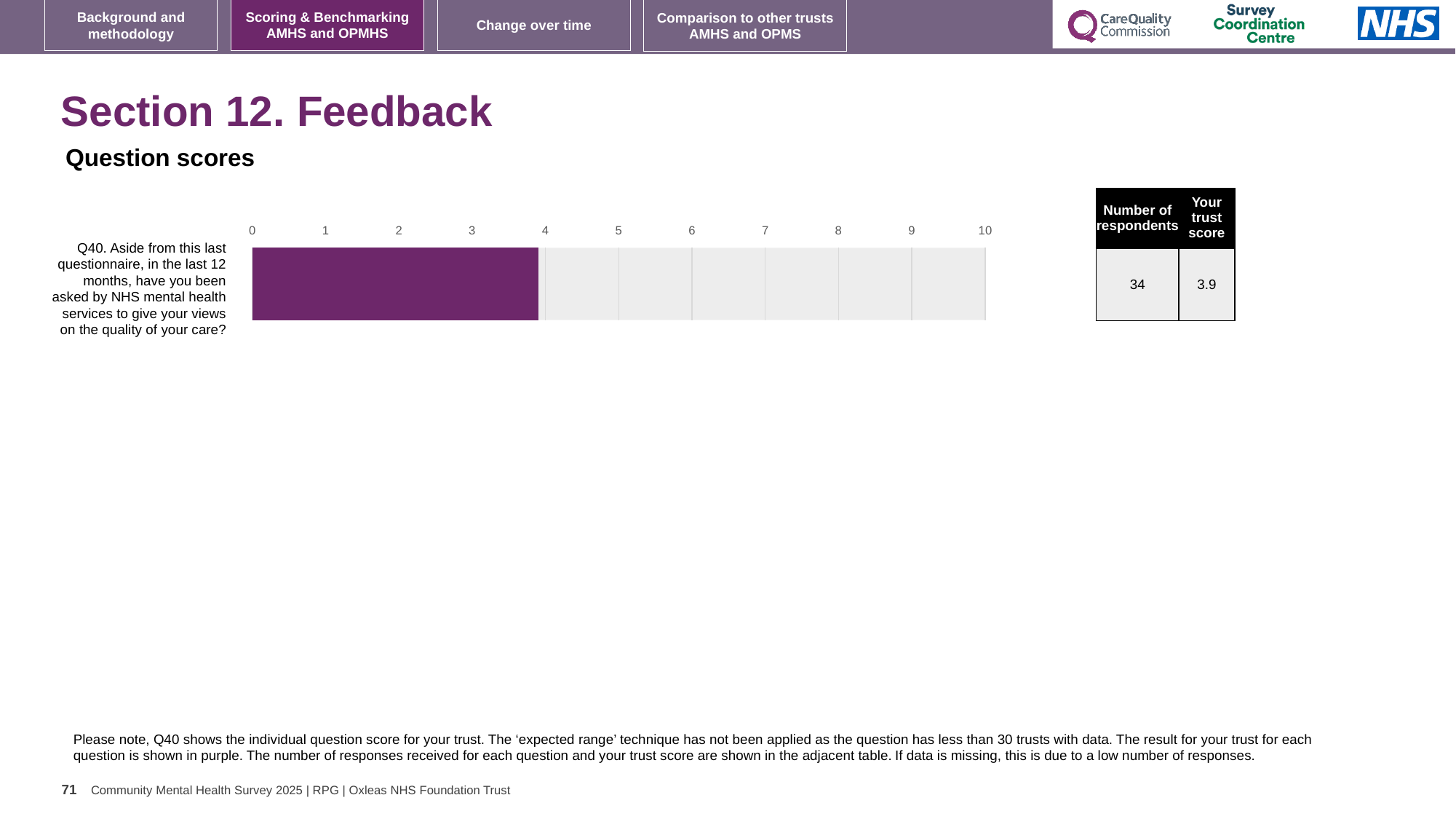
How many bars are plotted in the chart? 1 Is the value of the bar for Q40 greater or less than 5? less Is the value of the bar for Q40 greater or less than 8? less What colour is the bar for Q40? purple Is the value of the bar for Q40 greater or less than 3? greater What is the maximum value shown on the chart's horizontal axis? 10 What kind of chart is shown on the slide? bar chart How many respondents are listed in the table for Q40? 34 What is the trust score for Q40 shown in the adjacent table? 3.9